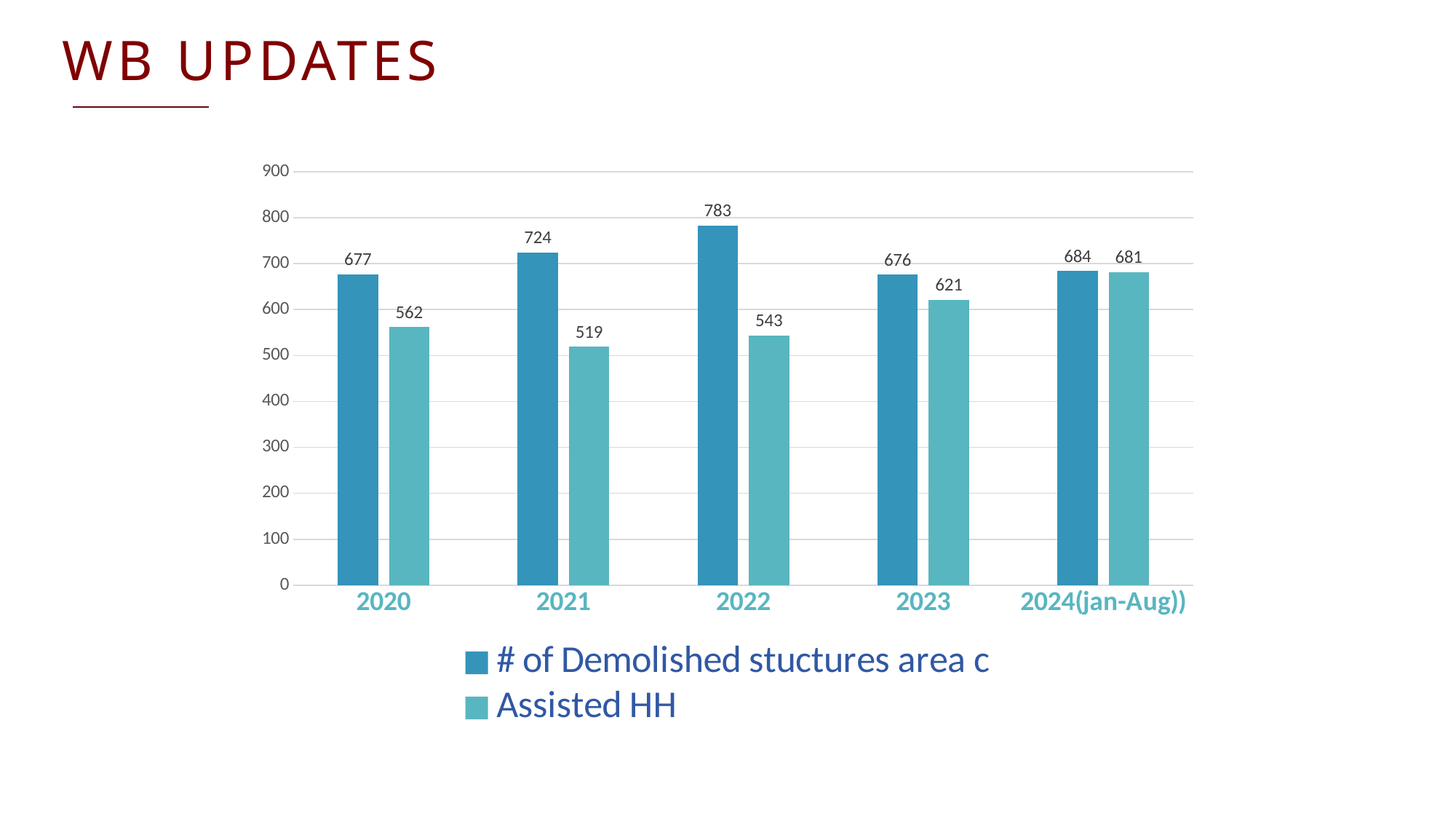
What is the value for Assisted HH in 2024(jan-Aug))? 681 How many series does the legend list? 2 What is the value for Assisted HH in 2021? 519 Which is larger: the number of demolished structures in area C in 2021 or in 2023? 2021 How many years (categories) are shown on the x axis? 5 What is the difference between the number of demolished structures in area C and Assisted HH in 2022? 240 Which year has the lowest value for Assisted HH? 2021 Which year has the highest number of demolished structures in area C? 2022 What is the difference between Assisted HH in 2023 and Assisted HH in 2020? 59 What is the number of demolished structures in area C in 2022? 783 What kind of chart is shown on the slide? Bar chart What is the title of the slide? WB UPDATES